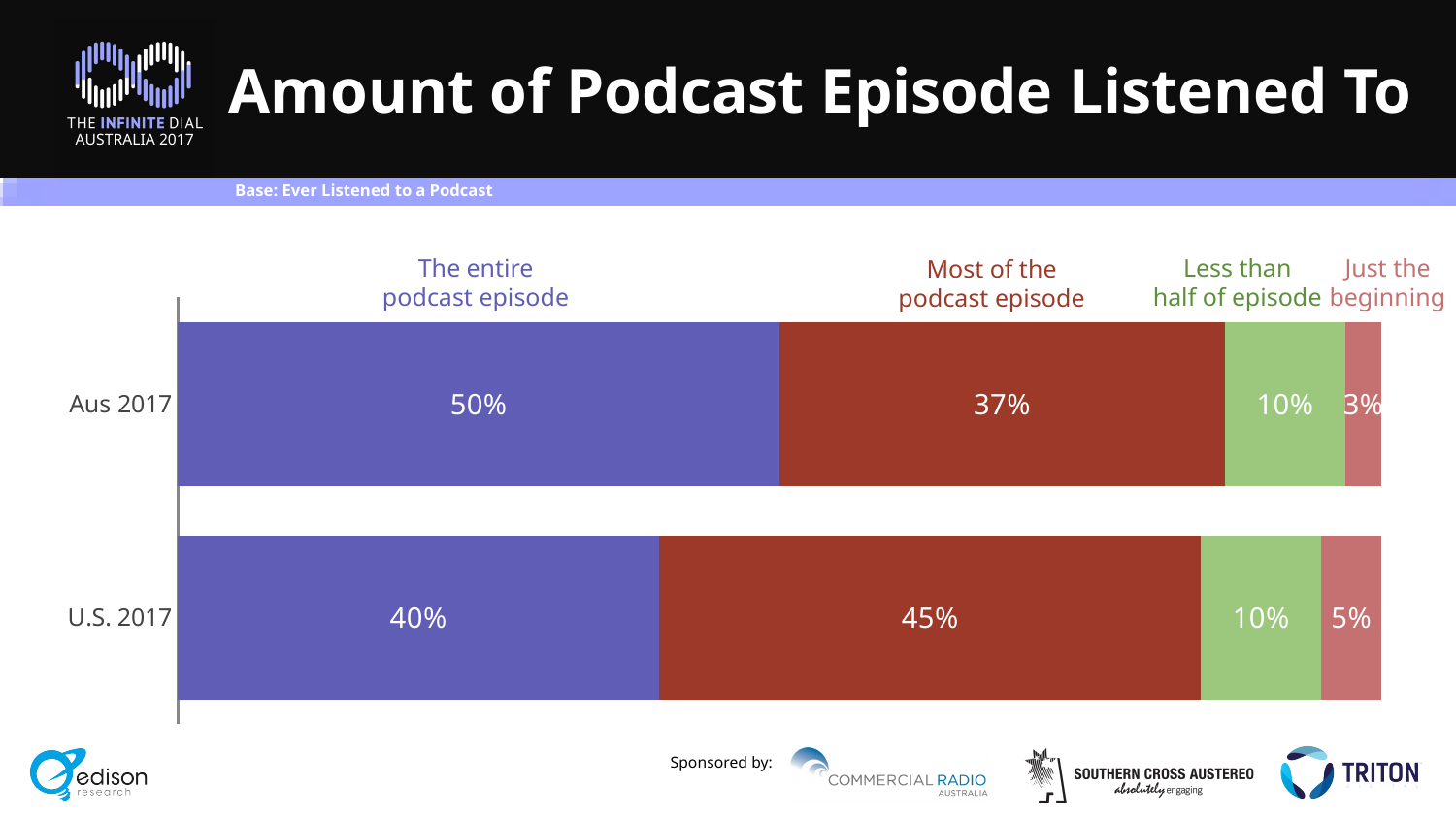
What is the difference between the Aus 2017 and U.S. 2017 shares for the entire podcast episode? 10% What kind of chart is shown on the slide? Stacked bar chart Which category has the largest share for Aus 2017? The entire podcast episode What is the title of the chart? Amount of Podcast Episode Listened To How many bars (rows) are plotted in the chart? 2 Which is larger: the Aus 2017 share for most of the podcast episode or the U.S. 2017 share for most of the podcast episode? U.S. 2017 What percentage of Aus 2017 respondents listened to less than half of the episode? 10% How many series (listening categories) does the chart show? 4 What percentage of U.S. 2017 respondents listened to most of the podcast episode? 45% Which category has the smallest share for U.S. 2017? Just the beginning What percentage of Aus 2017 respondents listened to the entire podcast episode? 50% What percentage of U.S. 2017 respondents listened to just the beginning? 5%